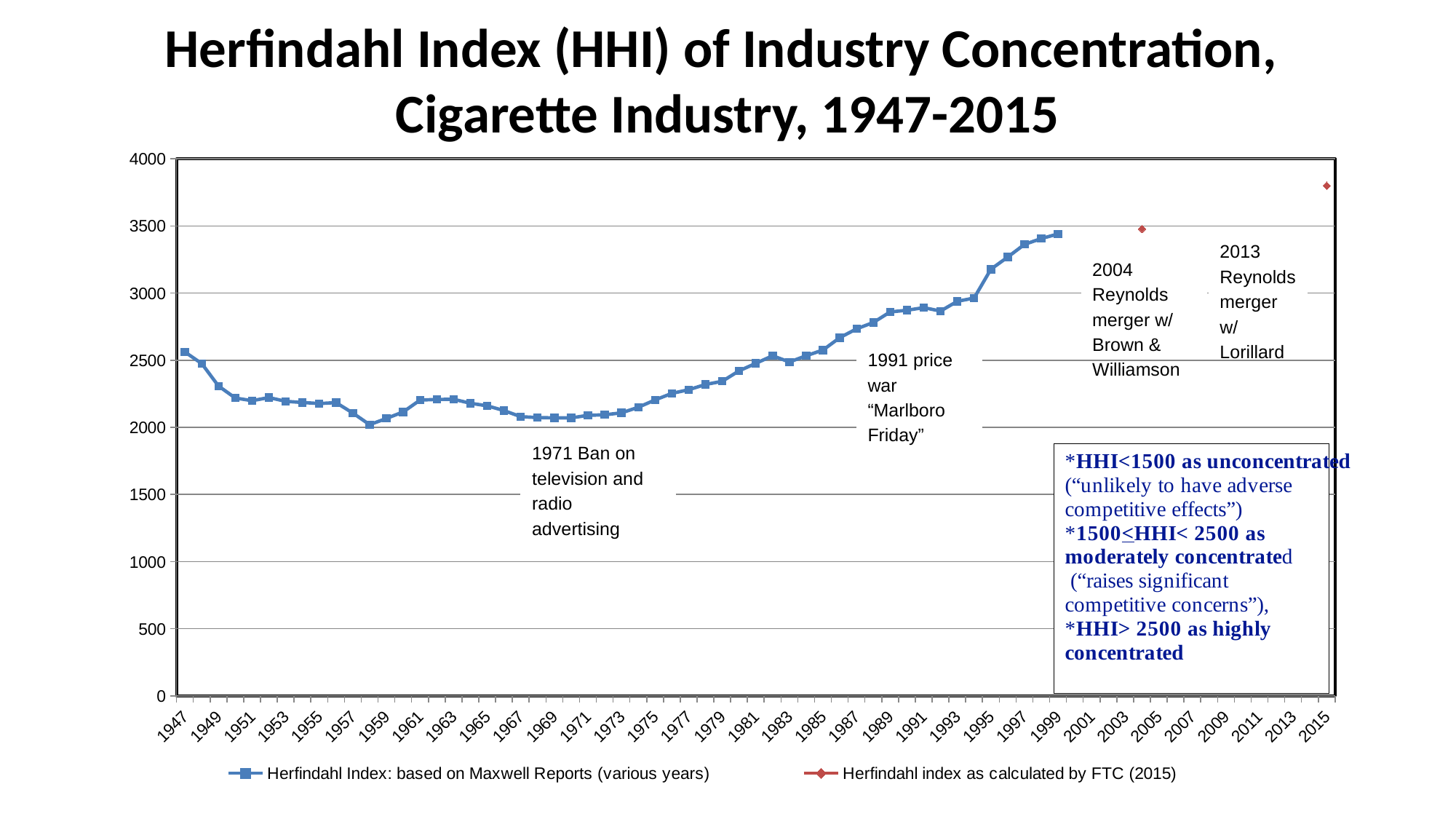
Which series is drawn with red diamond markers? Herfindahl index as calculated by FTC (2015) Is the Maxwell Reports Herfindahl Index value for 1947 greater or less than 2000? greater In which year does the Maxwell Reports Herfindahl Index series reach its highest value? 1999 Does the Maxwell Reports Herfindahl Index rise or fall between 1973 and 1999? rise What kind of chart is shown on the slide? line chart Which is larger, the Maxwell Reports Herfindahl Index value for 1947 or for 1999? 1999 How many series does the legend list? 2 Is the Maxwell Reports Herfindahl Index value for 1959 greater or less than 2500? less Does the Maxwell Reports Herfindahl Index rise or fall between 1947 and 1959? fall Is the FTC-calculated Herfindahl index value for 2015 greater or less than 3500? greater What is the title of the chart? Herfindahl Index (HHI) of Industry Concentration, Cigarette Industry, 1947-2015